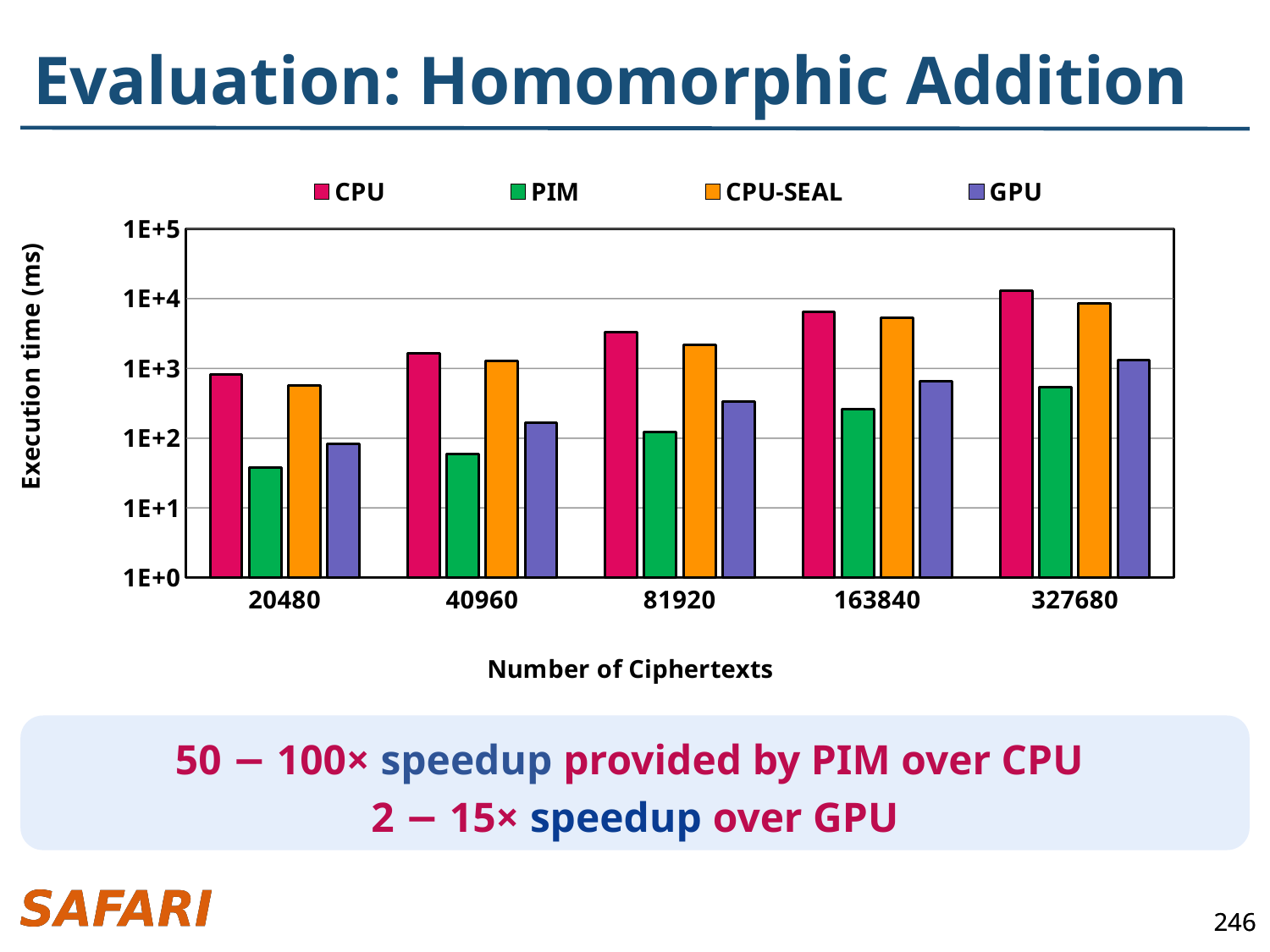
How many series does the legend list? 4 Is the PIM execution time at 327680 ciphertexts greater or less than 1E+3 ms? less Is the GPU execution time at 163840 ciphertexts greater or less than 1E+3 ms? less How many ciphertext counts are shown along the x axis? 5 Is the CPU execution time at 40960 ciphertexts greater or less than 1E+3 ms? greater Does the CPU execution time rise or fall as the number of ciphertexts increases? rise Which series has the shortest bar at 20480 ciphertexts? PIM What is the label of the y axis? Execution time (ms) Which series has the tallest bar at 327680 ciphertexts? CPU Which is larger at 327680 ciphertexts, the CPU bar or the CPU-SEAL bar? CPU What kind of chart is shown on the slide? bar chart